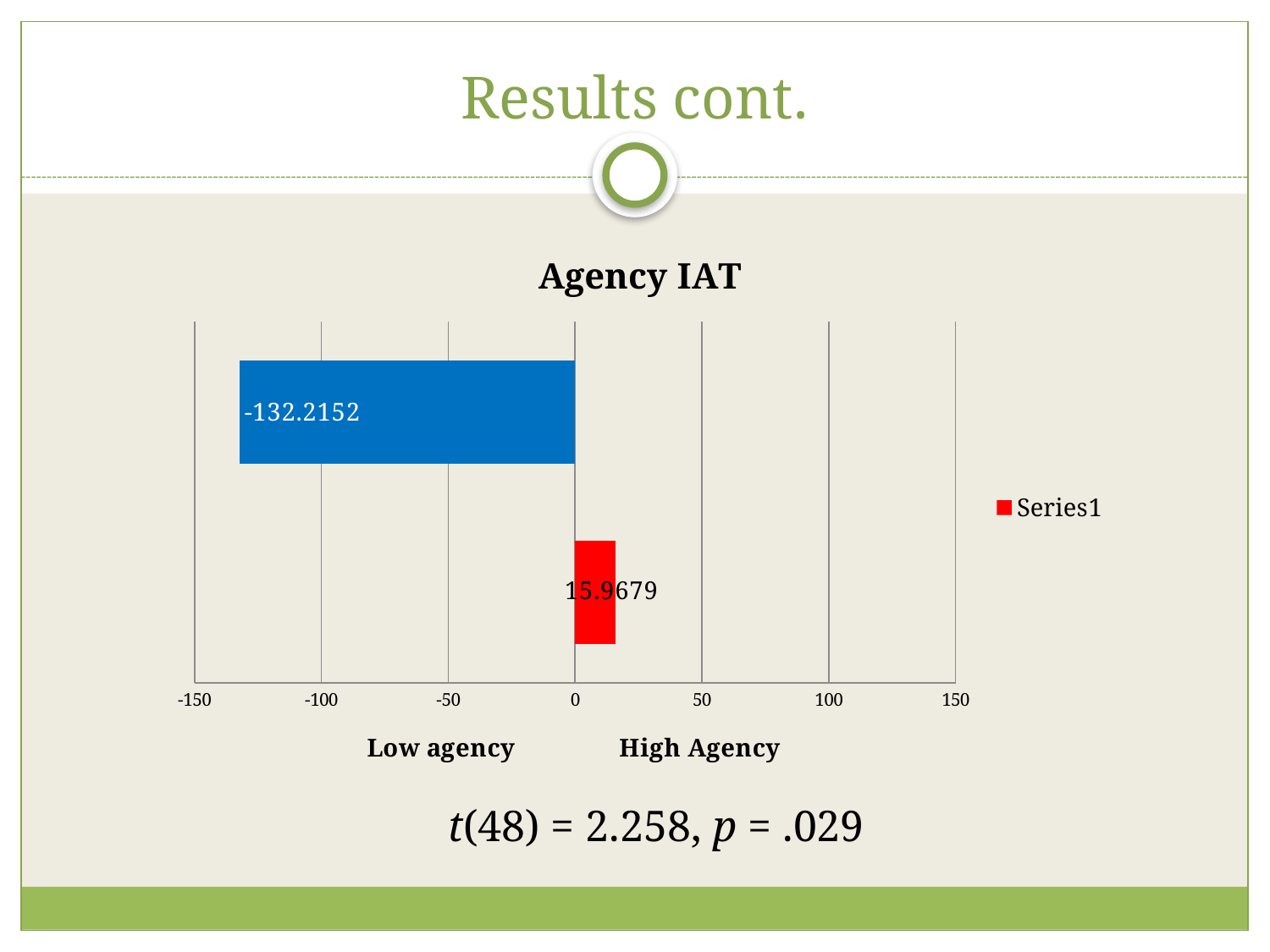
What is the value for Low agency in the Agency IAT chart? -132.2152 What kind of chart is the Agency IAT chart? bar chart Is the value for High Agency in the Agency IAT chart greater or less than 50? less What is the difference between the High Agency and Low agency values in the Agency IAT chart? 148.1831 How many series does the legend of the Agency IAT chart list? 1 Is the value for Low agency in the Agency IAT chart greater or less than -100? less Which category has the lowest value in the Agency IAT chart? Low agency What is the value for High Agency in the Agency IAT chart? 15.9679 How many categories are plotted in the Agency IAT chart? 2 Which is larger in the Agency IAT chart, the value for Low agency or the value for High Agency? High Agency What is the title of the chart on the slide? Agency IAT Which category has the highest value in the Agency IAT chart? High Agency